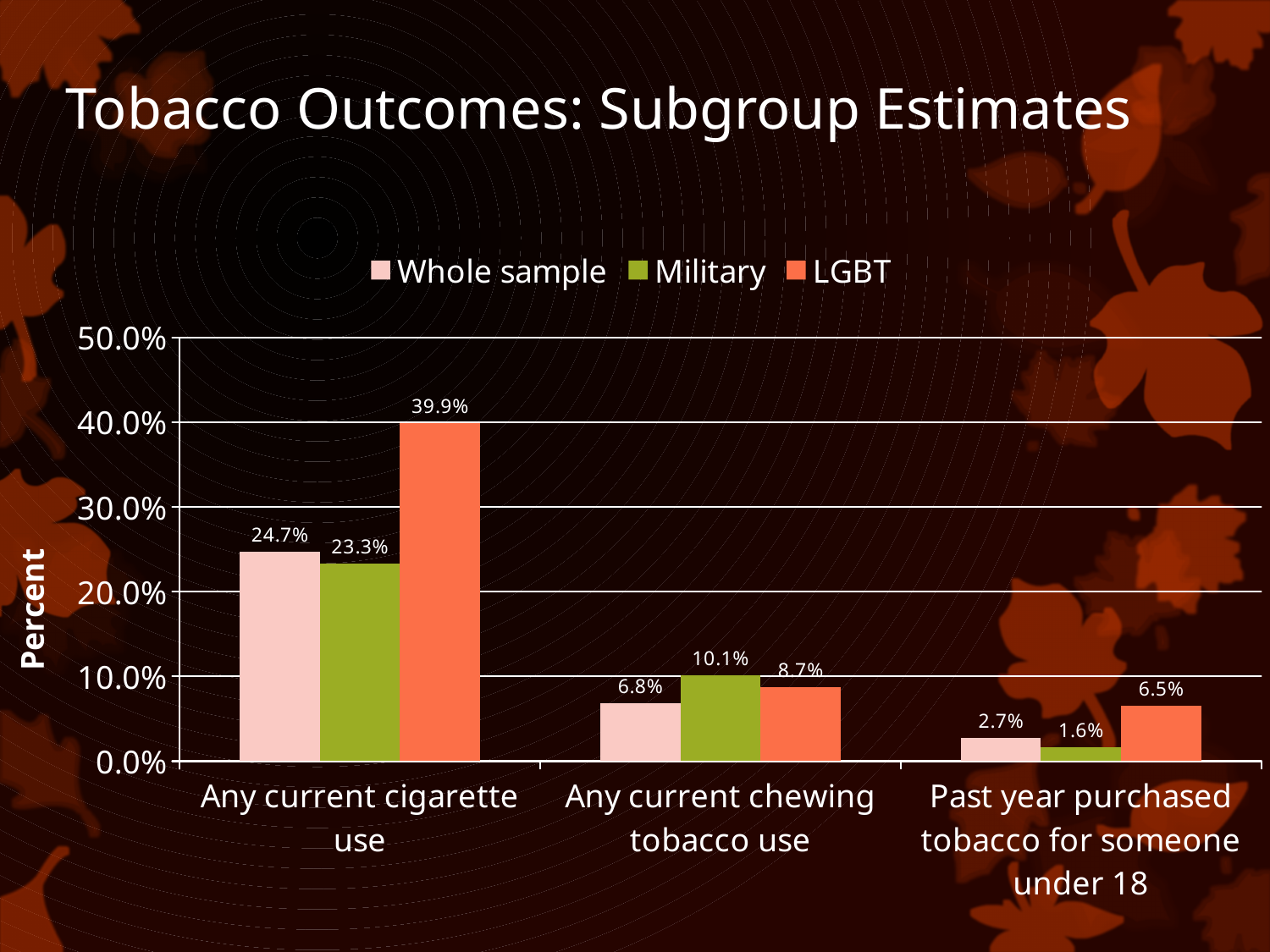
What is the Military value for Any current chewing tobacco use? 10.1% What is the Whole sample value for Past year purchased tobacco for someone under 18? 2.7% What is the label of the vertical axis? Percent How many series does the legend list? 3 Is the Whole sample value for Any current cigarette use greater or less than 20.0%? greater Which series has the lowest value for Past year purchased tobacco for someone under 18? Military What kind of chart is shown on the slide? bar chart What is the difference between the LGBT and Whole sample values for Any current cigarette use? 15.2% How many categories are shown on the x axis? 3 What is the LGBT value for Any current cigarette use? 39.9% Which series has the highest value for Any current cigarette use? LGBT Which is larger for Any current chewing tobacco use: the Military value or the LGBT value? Military